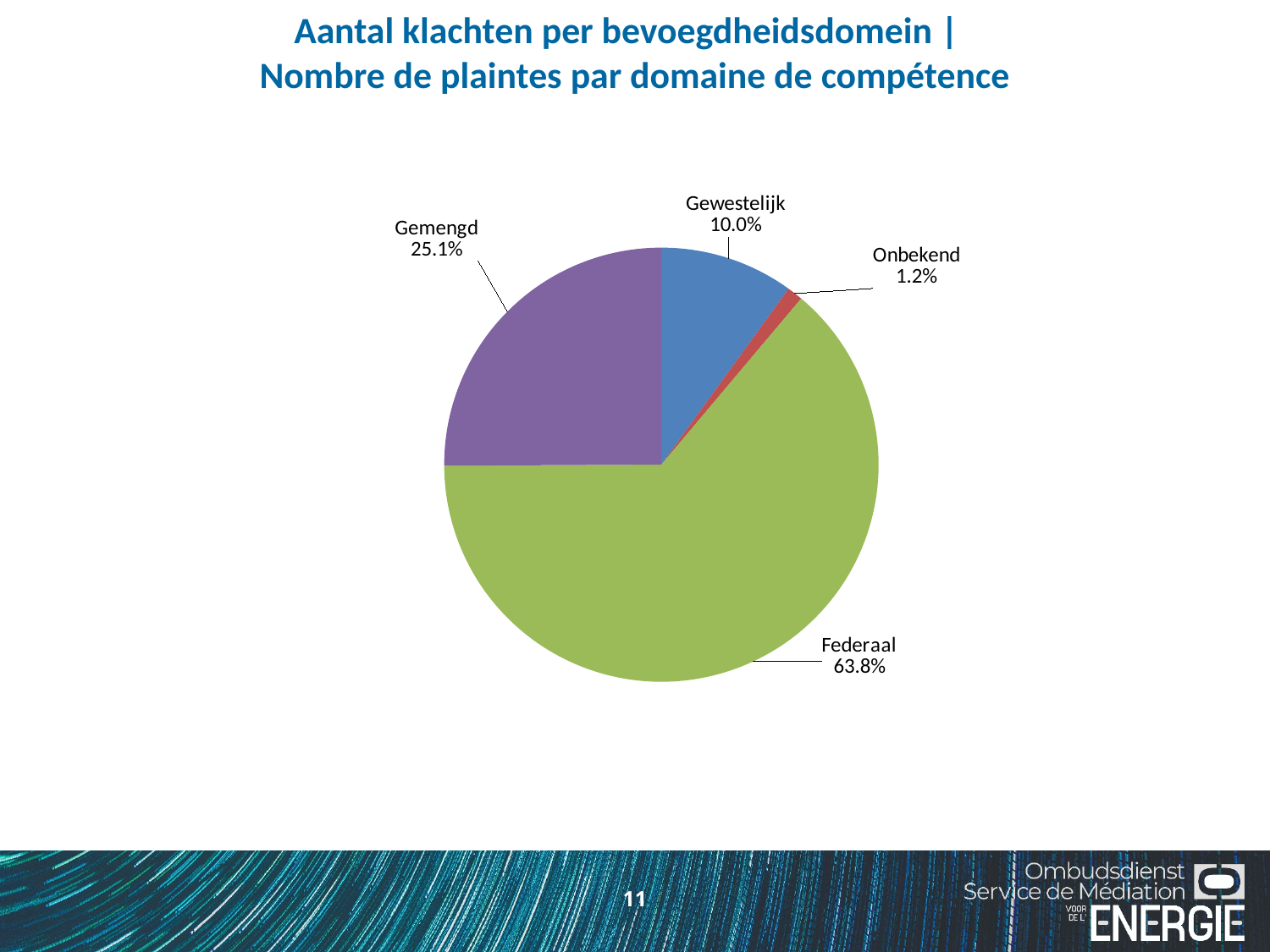
What kind of chart is shown on the slide? pie chart How many slices does the pie chart have? 4 Which category has the smallest slice of the pie? Onbekend Which is larger, the Gemengd slice or the Gewestelijk slice? Gemengd What share of complaints is labelled Gemengd? 25.1% What is the difference in percentage points between Gewestelijk and Onbekend? 8.8 What is the difference in percentage points between Federaal and Gemengd? 38.7 Which category has the largest slice of the pie? Federaal What share of complaints is labelled Federaal? 63.8% What colour is the Federaal slice? green What share of complaints is labelled Onbekend? 1.2%